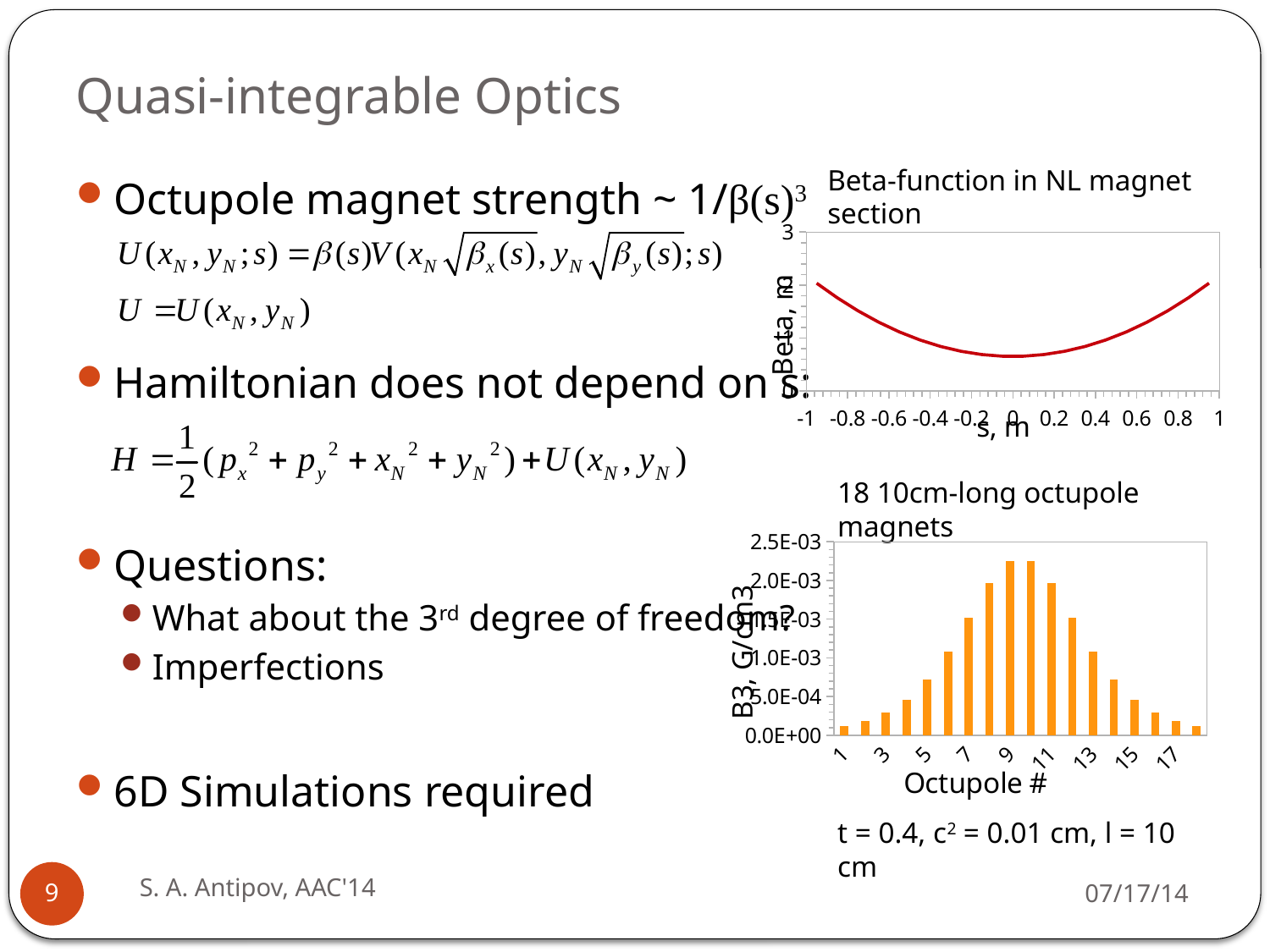
What is the x-axis label of the '18 10cm-long octupole magnets' chart? Octupole # In the '18 10cm-long octupole magnets' chart, is the value for octupole 1 greater or less than 5.0E-04? less What kind of chart is the 'Beta-function in NL magnet section' chart? line chart What kind of chart is the '18 10cm-long octupole magnets' chart? bar chart In the '18 10cm-long octupole magnets' chart, is the value for octupole 7 greater or less than 1.0E-03? greater In the 'Beta-function in NL magnet section' chart, how does the beta value change as s goes from -1 to 1? falls to a minimum near s = 0, then rises In the '18 10cm-long octupole magnets' chart, is the value for octupole 5 greater or less than 1.0E-03? less In the '18 10cm-long octupole magnets' chart, how many bars are plotted? 18 In the '18 10cm-long octupole magnets' chart, how do the bar values change from octupole 1 to octupole 18? rise to a peak in the middle, then fall In the '18 10cm-long octupole magnets' chart, which is larger, the value for octupole 9 or octupole 1? octupole 9